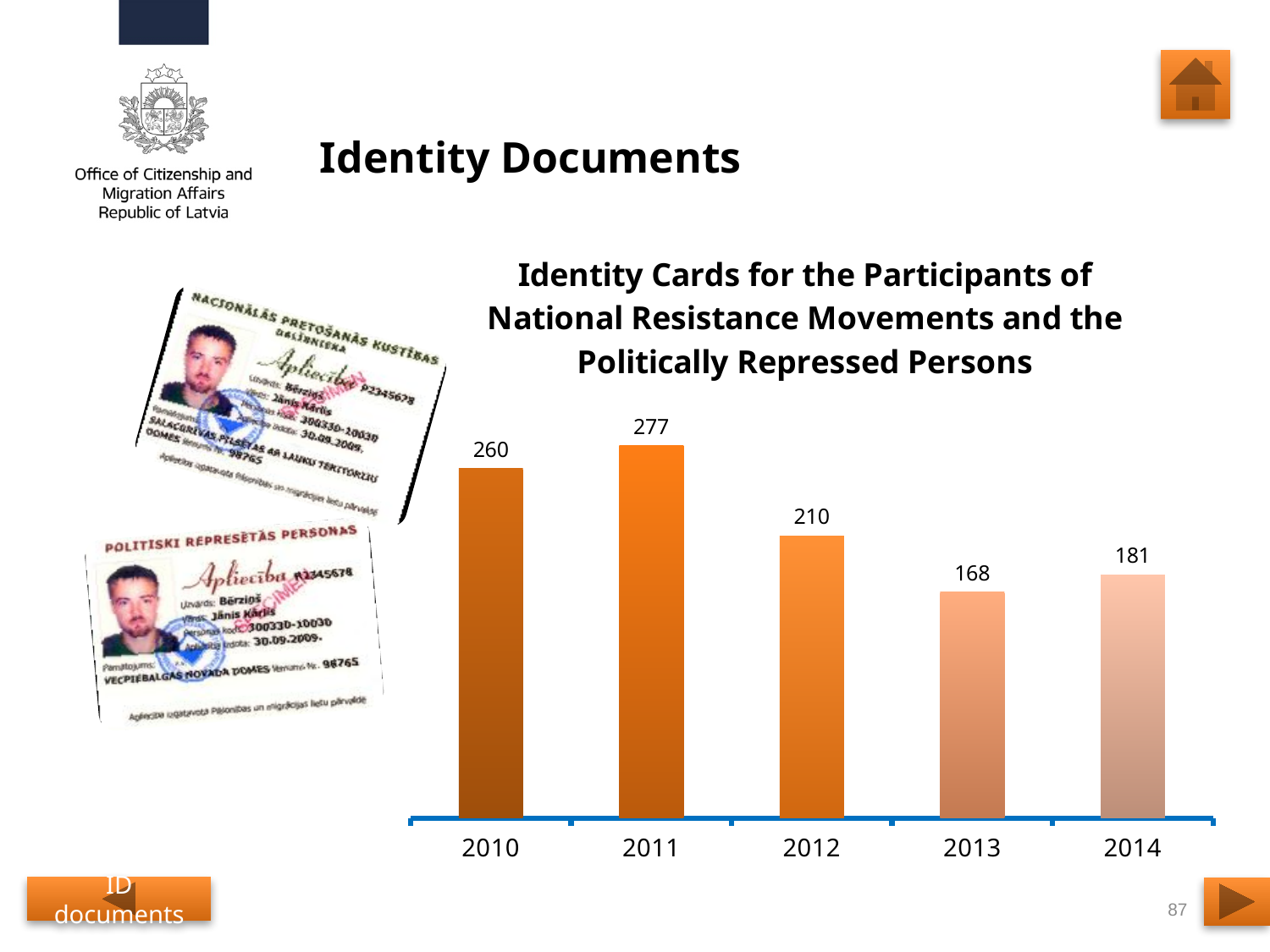
Which year has the highest value? 2011 Do the values generally rise or fall from 2011 to 2013? fall How many years are shown on the chart? 5 What is the value for 2014? 181 What kind of chart is this? bar chart What is the title of the chart? Identity Cards for the Participants of National Resistance Movements and the Politically Repressed Persons Which year has the lowest value? 2013 What is the difference between the values for 2014 and 2013? 13 What is the value for 2013? 168 What is the difference between the values for 2011 and 2012? 67 What is the value for 2010? 260 Which is larger, the value for 2010 or the value for 2012? 2010